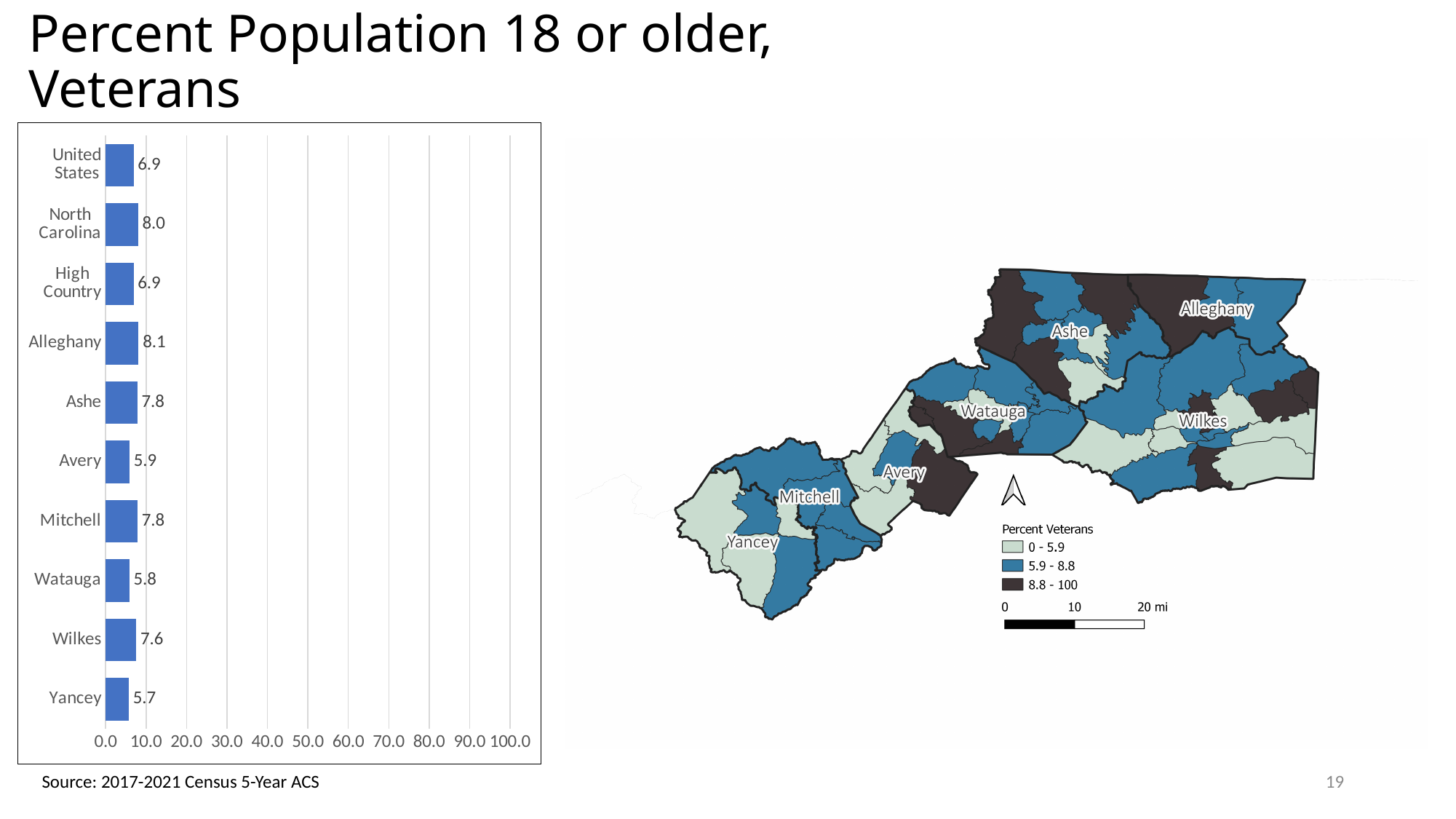
Which category has the highest value in the bar chart? Alleghany Is the value for Mitchell in the bar chart greater or less than 10.0? less What is the value for Watauga in the bar chart? 5.8 Which category has the lowest value in the bar chart? Yancey Which has a larger value in the bar chart, Ashe or Avery? Ashe What is the highest value shown on the x axis of the bar chart? 100.0 How many categories are shown in the bar chart? 10 What is the difference between the values for North Carolina and the United States in the bar chart? 1.1 What is the value for Wilkes in the bar chart? 7.6 What is the value for North Carolina in the bar chart? 8.0 What kind of chart is shown on the left of the slide? bar chart What is the value for Alleghany in the bar chart? 8.1